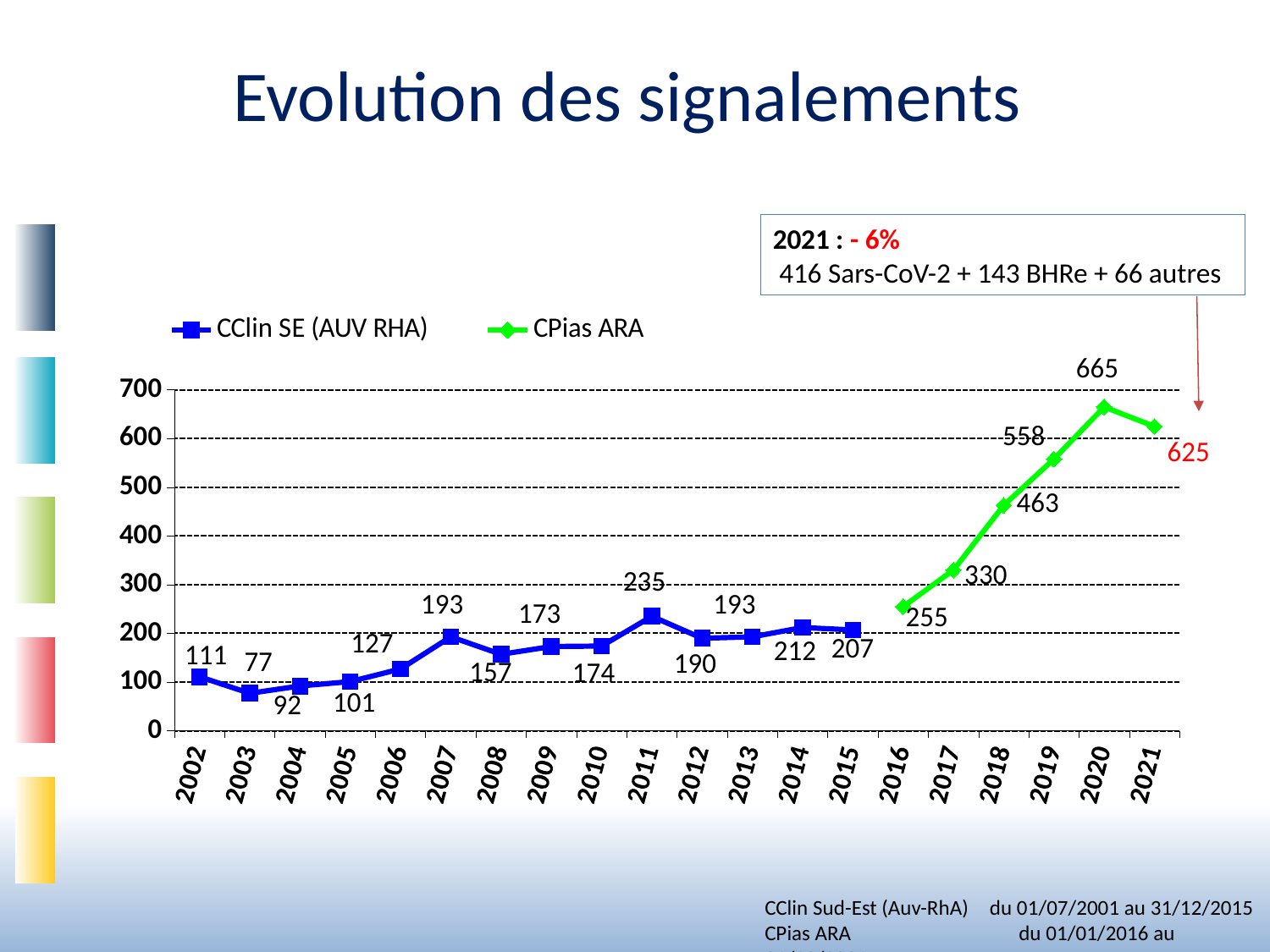
What is the value for 2011 in the CClin SE (AUV RHA) series? 235 Which is larger, the value for 2014 or the value for 2015? 2014 What is the value for 2020 in the CPias ARA series? 665 What is the difference between the values for 2020 and 2021? 40 What is the difference between the values for 2019 and 2018? 95 What is the value for 2021? 625 Do the values of the CPias ARA series rise or fall from 2016 to 2020? rise Which year has the lowest value on the chart? 2003 Which year has the highest value on the chart? 2020 How many years are shown on the x axis? 20 What kind of chart is shown on the slide? line chart How many series does the legend list? 2